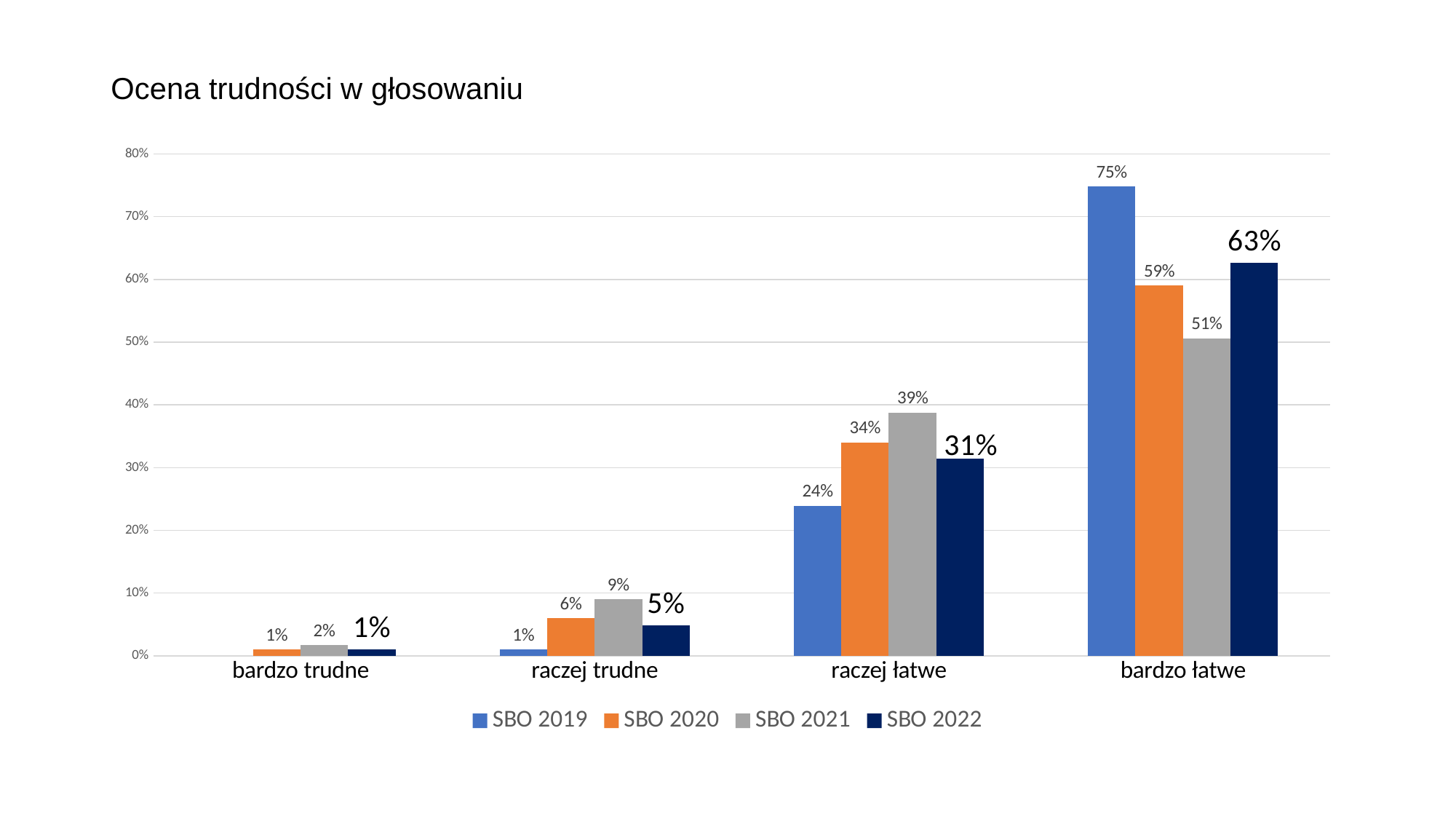
What is the title of the chart? Ocena trudności w głosowaniu What is the value for SBO 2019 in the "raczej łatwe" category? 24% Which series has the highest value in the "bardzo łatwe" category? SBO 2019 How many series does the legend list? 4 How many categories are shown on the x axis? 4 What kind of chart is shown on the slide? bar chart What is the value for SBO 2022 in the "bardzo łatwe" category? 63% What is the difference between SBO 2019 and SBO 2021 in the "bardzo łatwe" category? 24% Is the value for SBO 2020 in the "bardzo łatwe" category greater or less than 50%? greater Which is larger in the "raczej łatwe" category: SBO 2020 or SBO 2021? SBO 2021 Which series has the lowest value in the "raczej łatwe" category? SBO 2019 What is the value for SBO 2021 in the "raczej trudne" category? 9%